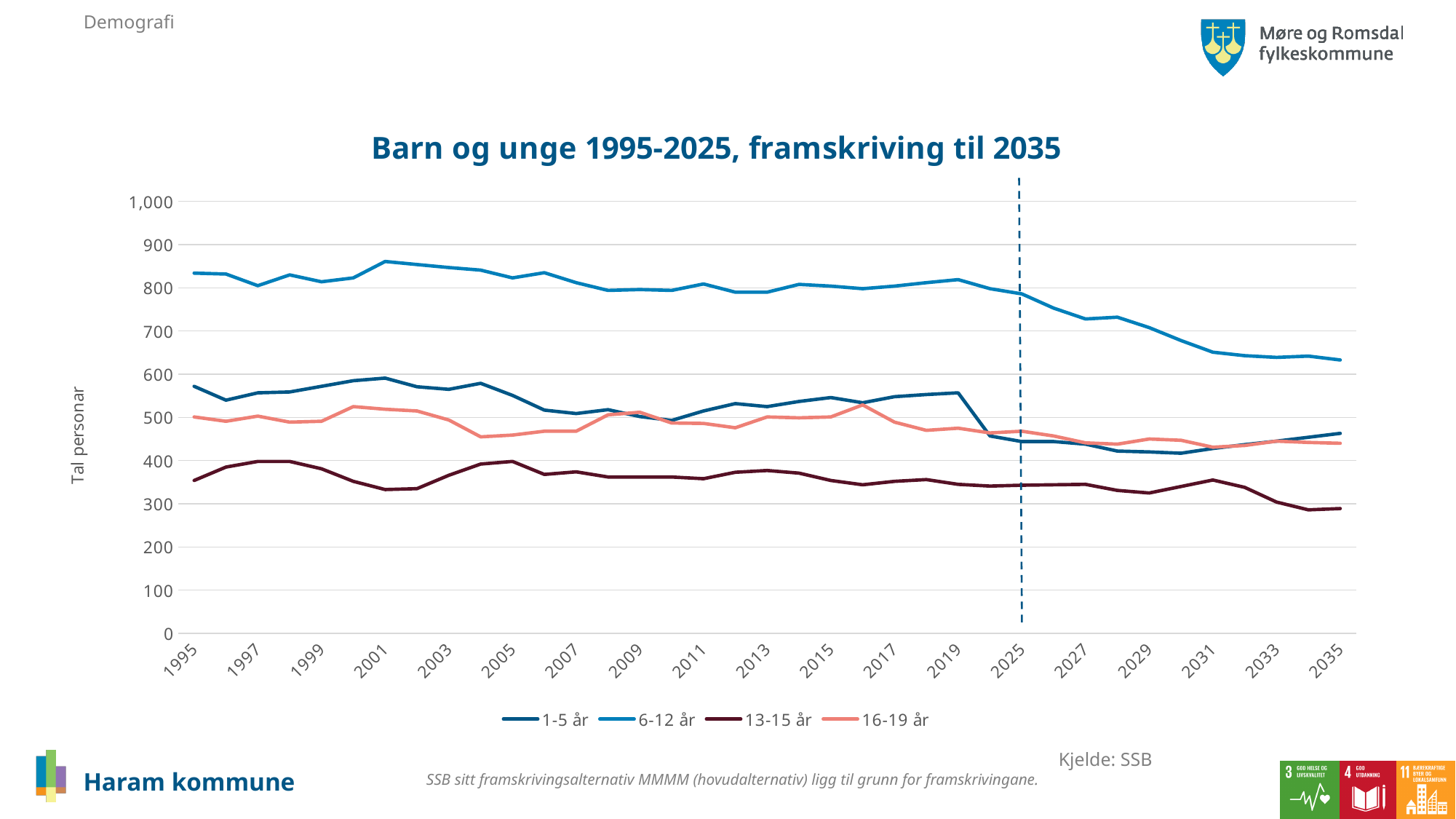
Does the 6-12 år line rise or fall between 2025 and 2035? fall Is the value for 13-15 år in 2035 greater or less than 300? less Which age group has the lowest value in 2035? 13-15 år How many year labels are shown on the x axis? 19 What is the title of the chart? Barn og unge 1995-2025, framskriving til 2035 What is the label on the vertical axis? Tal personar Is the value for 6-12 år in 2001 greater or less than 800? greater What kind of chart is shown on the slide? line chart Which age group has the highest values across the whole period? 6-12 år In 2035, which is larger: the value for 1-5 år or for 16-19 år? 1-5 år How many series does the legend list? 4 Is the value for 1-5 år in 2001 greater or less than 500? greater